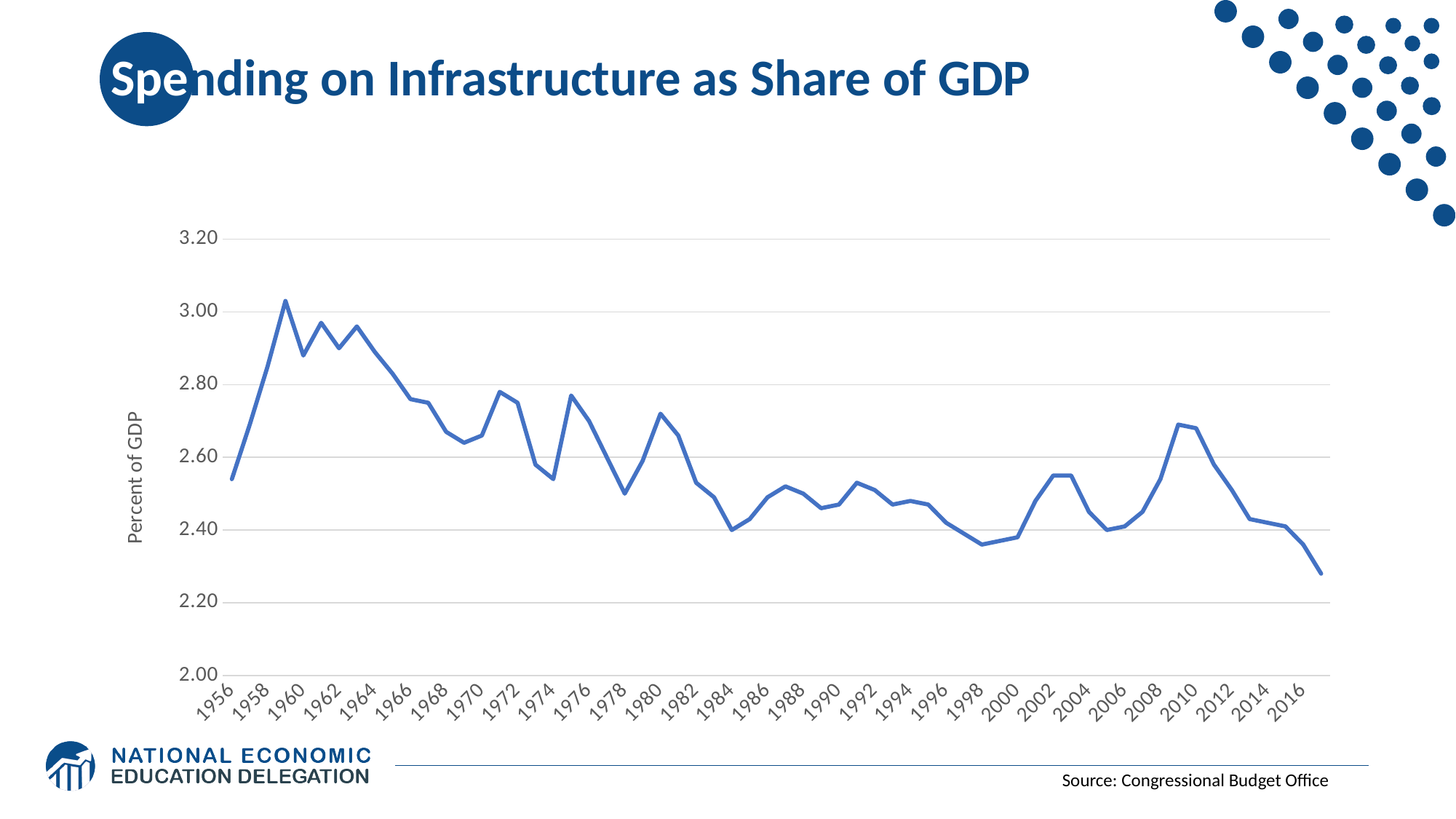
In which year does infrastructure spending as a share of GDP reach its highest point? 1959 Is the value for 2017 greater or less than 2.40? less Which year has the higher value, 1964 or 1984? 1964 In which year is infrastructure spending as a share of GDP at its lowest point? 2017 Is the value for 1956 greater or less than 2.40? greater What is the title of the chart? Spending on Infrastructure as Share of GDP What is the label on the vertical axis of the chart? Percent of GDP Which year has the higher value, 1959 or 2009? 1959 What kind of chart is shown on the slide? line chart Overall, does infrastructure spending as a share of GDP rise or fall from 1956 to 2017? fall Is the value for 2009 greater or less than 2.60? greater